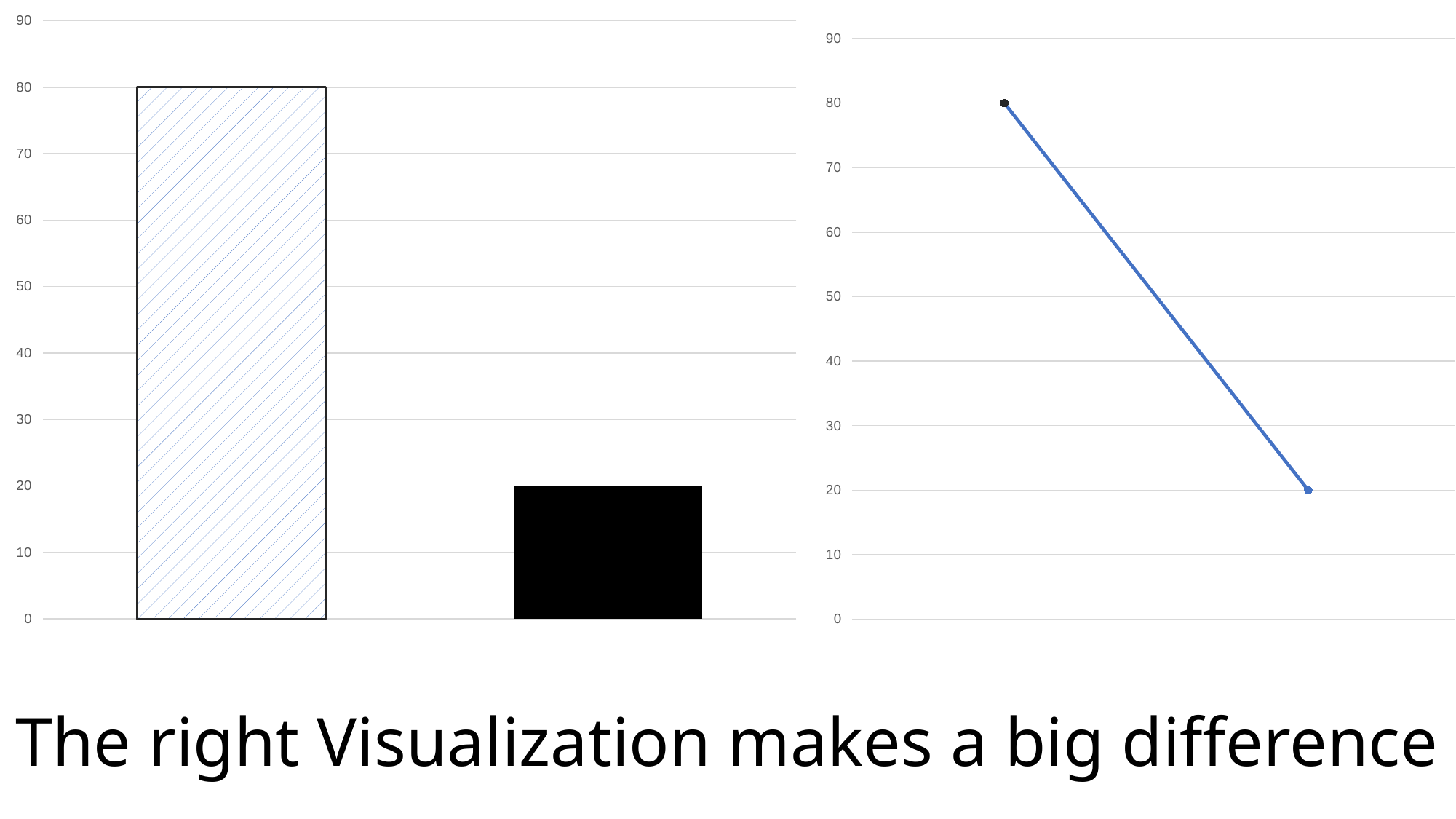
In the bar chart on the left, what is the value of the left (hatched) bar? 80 In the bar chart on the left, which bar is taller, the left bar or the right bar? the left bar In the bar chart on the left, is the value of the right (solid black) bar greater or less than 50? less In the bar chart on the left, what is the difference between the left bar and the right bar? 60 In the line chart on the right, how many data points are plotted? 2 What type of chart is the chart on the left of the slide? bar chart In the line chart on the right, do the values rise or fall from left to right? fall In the line chart on the right, what is the value of the first (leftmost) point? 80 In the bar chart on the left, what is the value of the right (solid black) bar? 20 In the bar chart on the left, how many bars are plotted? 2 In the line chart on the right, what is the value of the last (rightmost) point? 20 What type of chart is the chart on the right of the slide? line chart